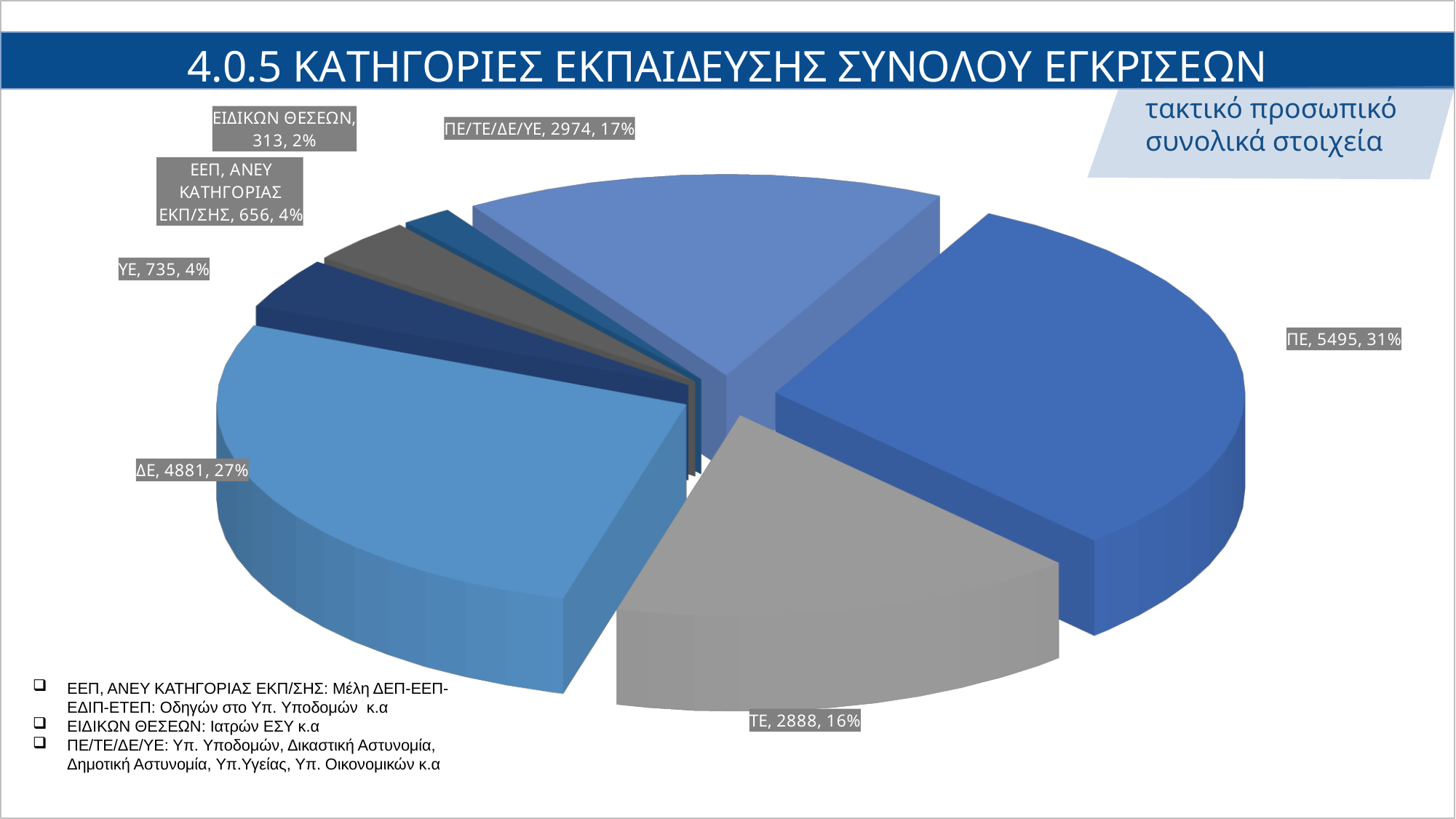
What is the difference between the values for ΠΕ and ΔΕ? 614 What is the value for ΕΙΔΙΚΩΝ ΘΕΣΕΩΝ? 313 What kind of chart is shown on the slide? pie chart What share of the pie does ΠΕ/ΤΕ/ΔΕ/ΥΕ represent? 17% What is the value for ΤΕ? 2888 How many slices does the pie chart have? 7 What is the value for ΔΕ? 4881 Which is larger, the value for ΤΕ or the value for ΠΕ/ΤΕ/ΔΕ/ΥΕ? ΠΕ/ΤΕ/ΔΕ/ΥΕ What share of the pie does ΔΕ represent? 27% Which category has the smallest slice? ΕΙΔΙΚΩΝ ΘΕΣΕΩΝ What is the value for ΠΕ? 5495 Which category has the largest slice? ΠΕ